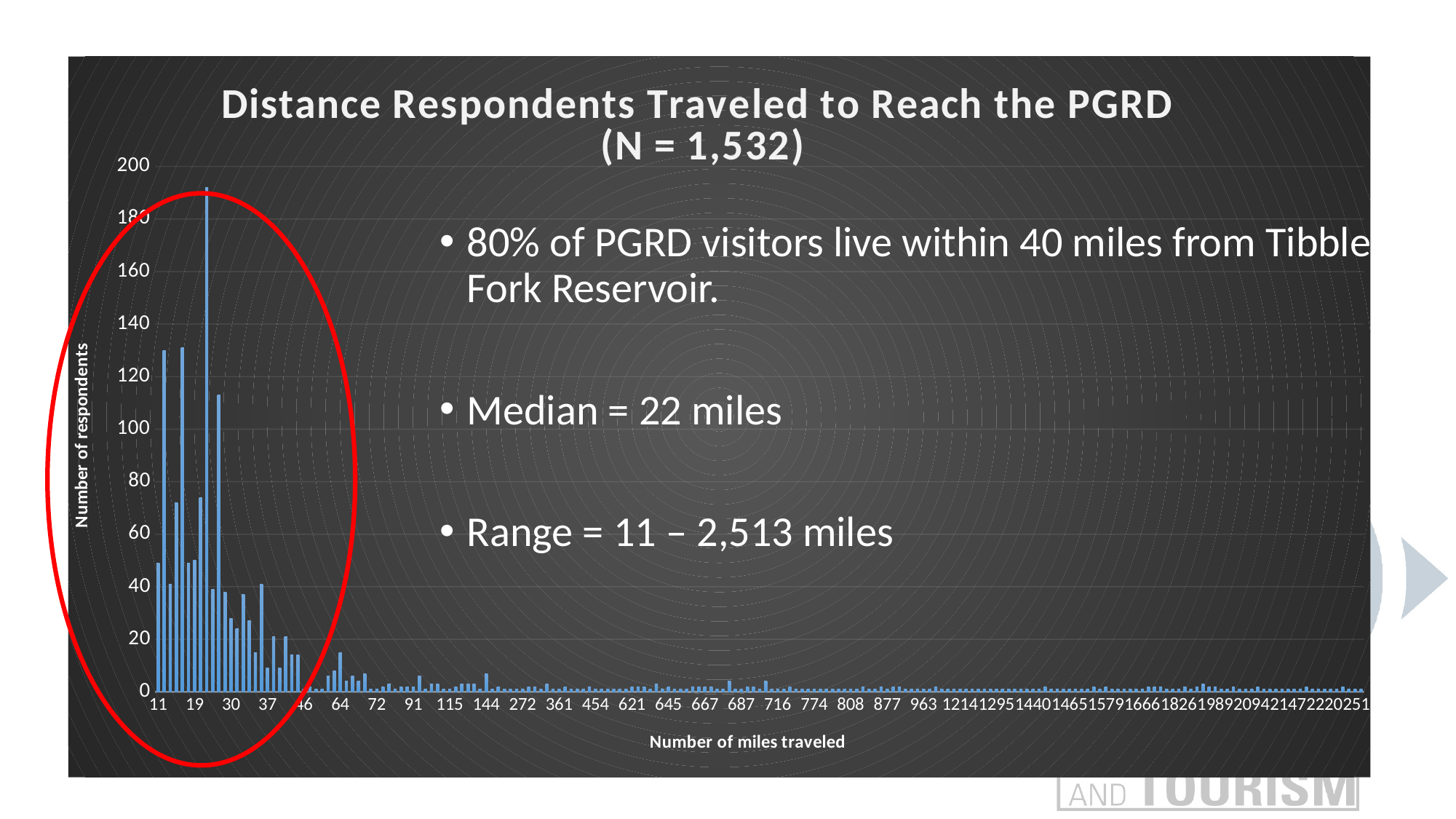
What is the label of the vertical axis of the chart? Number of respondents Is the number of respondents for 11 miles greater or less than 60? less What is the title of the chart? Distance Respondents Traveled to Reach the PGRD (N = 1,532) Is the value of the tallest bar in the chart greater or less than 180? greater Is the number of respondents for 2513 miles greater or less than 20? less What is the highest value shown on the vertical axis of the chart? 200 Which has more respondents, 11 miles or 2513 miles? 11 miles What kind of chart is shown on the slide? bar chart